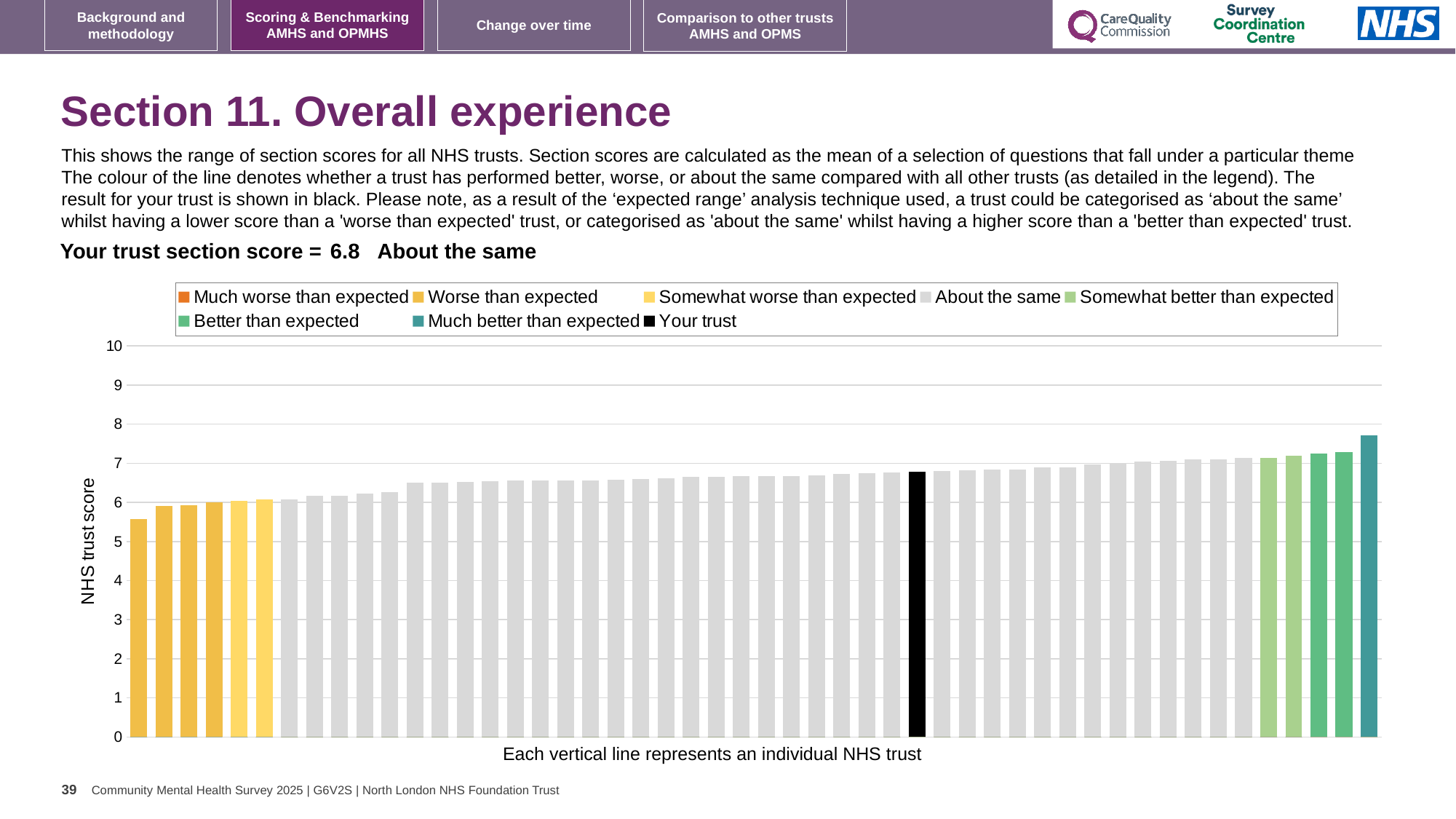
Which legend category does the highest bar belong to? Much better than expected What is the section score for your trust? 6.8 What is the label on the vertical axis of the chart? NHS trust score Is the value of the leftmost (lowest) bar greater or less than 6? less Is the value of the rightmost (highest) bar greater or less than 8? less How many bars are coloured as 'Much better than expected'? 1 What kind of chart is shown on the slide? Bar chart Do the bar values rise or fall from left to right along the x axis? Rise Is the value of the black 'Your trust' bar greater or less than 6? greater Which legend category is your trust placed in? About the same How many entries does the chart legend list? 8